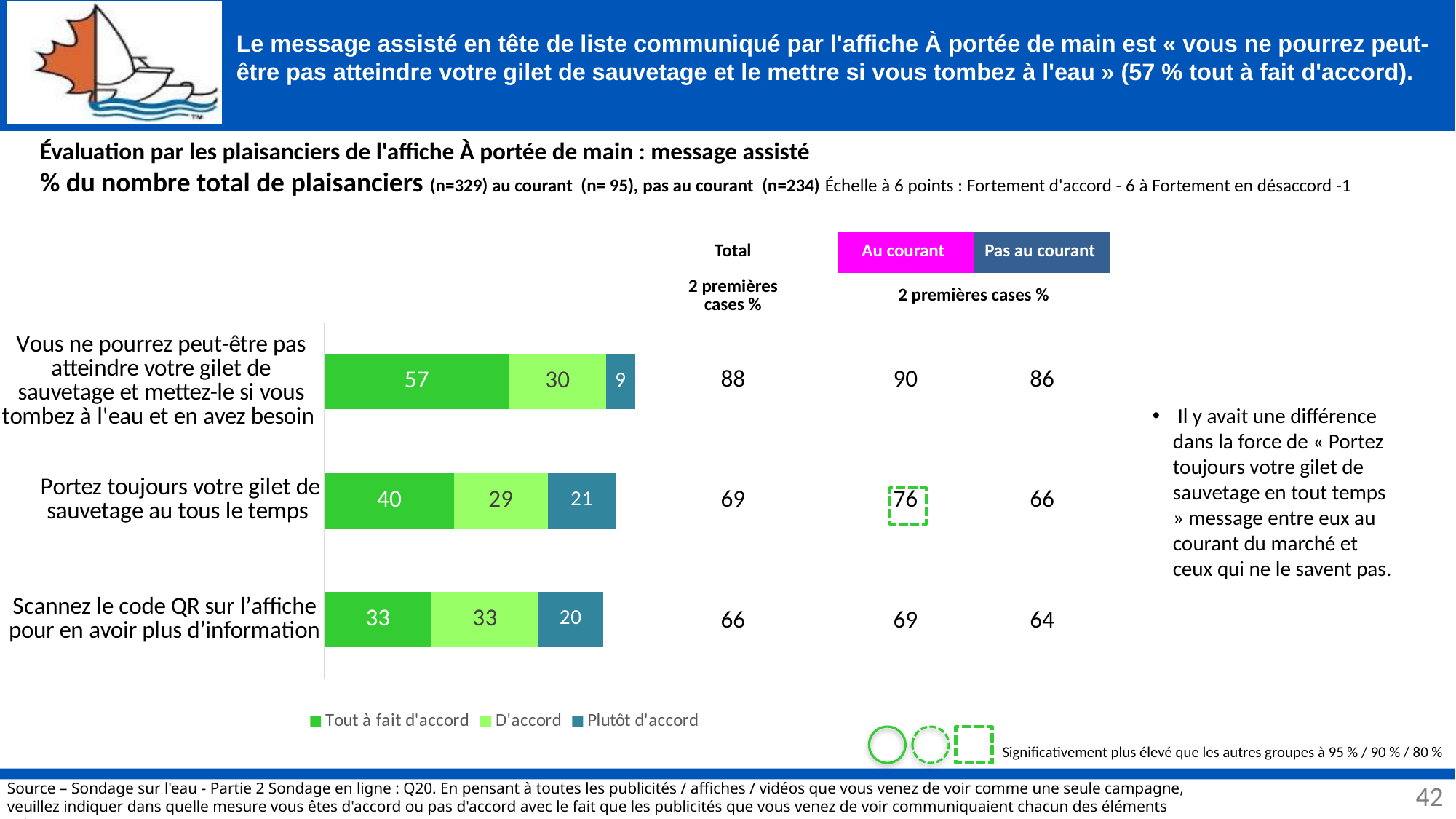
What is the 'Tout à fait d'accord' value for 'Vous ne pourrez peut-être pas atteindre votre gilet de sauvetage et mettez-le si vous tombez à l'eau et en avez besoin'? 57 Which is larger: the 'D'accord' value for 'Portez toujours votre gilet de sauvetage au tous le temps' or for 'Scannez le code QR sur l'affiche pour en avoir plus d'information'? Scannez le code QR sur l'affiche pour en avoir plus d'information What type of chart is shown on the slide? stacked bar chart What is the 'Au courant' 2 premières cases % value for 'Portez toujours votre gilet de sauvetage au tous le temps'? 76 Which statement has the lowest 'Plutôt d'accord' value? Vous ne pourrez peut-être pas atteindre votre gilet de sauvetage et mettez-le si vous tombez à l'eau et en avez besoin How many series does the chart legend list? 3 What is the total of the stacked bar for 'Portez toujours votre gilet de sauvetage au tous le temps'? 90 What is the difference between the 'Tout à fait d'accord' values for 'Vous ne pourrez peut-être pas atteindre votre gilet de sauvetage...' and 'Portez toujours votre gilet de sauvetage au tous le temps'? 17 Which statement has the highest 'Tout à fait d'accord' value? Vous ne pourrez peut-être pas atteindre votre gilet de sauvetage et mettez-le si vous tombez à l'eau et en avez besoin What is the 'Plutôt d'accord' value for 'Portez toujours votre gilet de sauvetage au tous le temps'? 21 How many categories (statements) are plotted in the bar chart? 3 What is the 'D'accord' value for 'Scannez le code QR sur l'affiche pour en avoir plus d'information'? 33